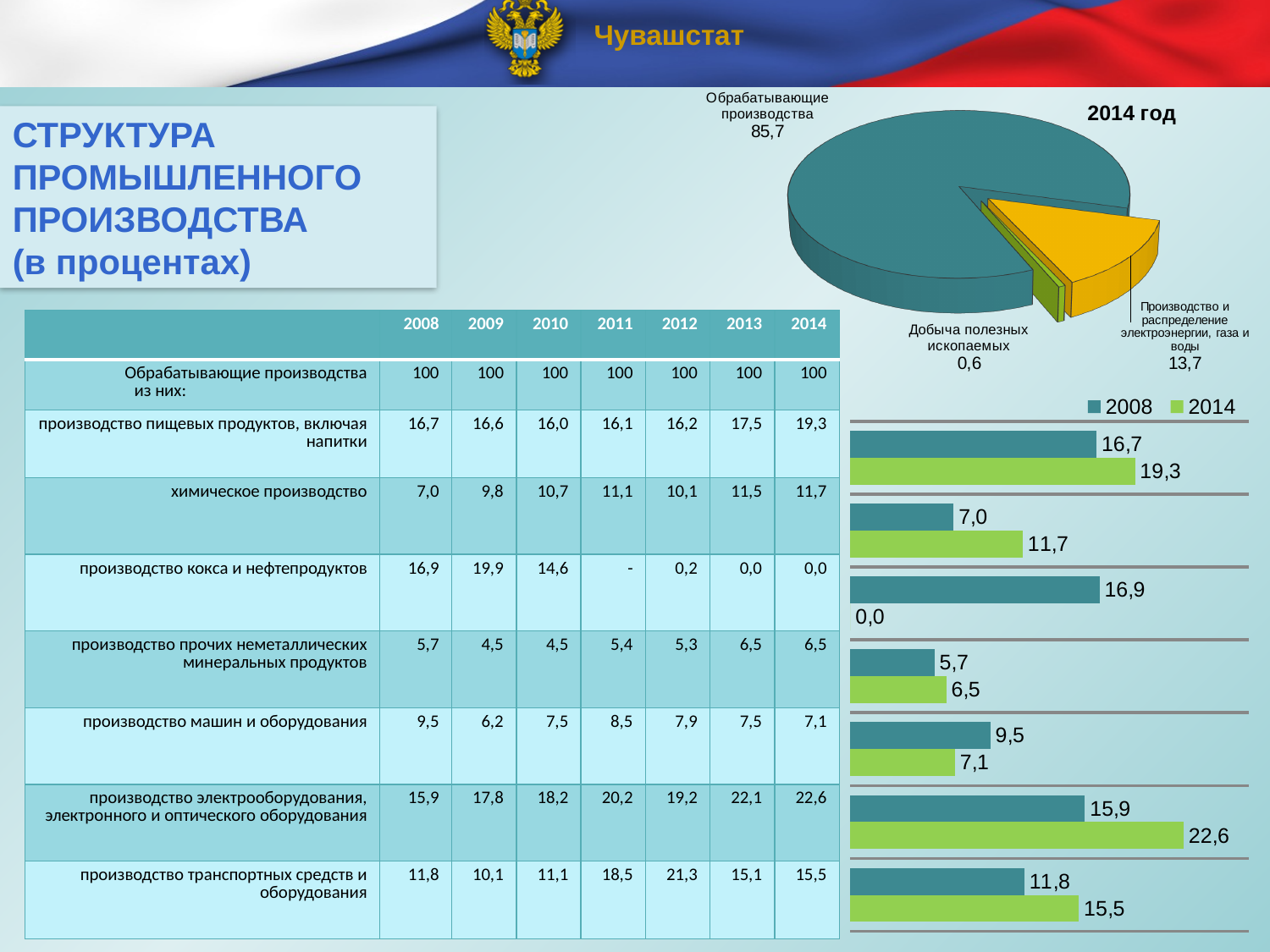
In the pie chart for 2014 год, what is the value for Добыча полезных ископаемых? 0,6 In the pie chart for 2014 год, what is the value for Обрабатывающие производства? 85,7 How many slices does the pie chart for 2014 год have? 3 In the bar chart on the right, what is the 2008 value in the bottom pair of bars? 11,8 In the bar chart on the right, which is larger in the third pair of bars: the 2008 value or the 2014 value? 2008 In the pie chart for 2014 год, which slice is the largest? Обрабатывающие производства In the pie chart for 2014 год, which slice is the smallest? Добыча полезных ископаемых In the bar chart on the right, what is the difference between the 2014 and 2008 values in the sixth pair of bars (15,9 and 22,6)? 6,7 What kind of chart is the chart on the right side of the slide below the pie chart? bar chart In the pie chart for 2014 год, what is the value for Производство и распределение электроэнергии, газа и воды? 13,7 How many series does the legend of the bar chart on the right list? 2 In the bar chart on the right, what is the 2014 value in the topmost pair of bars? 19,3